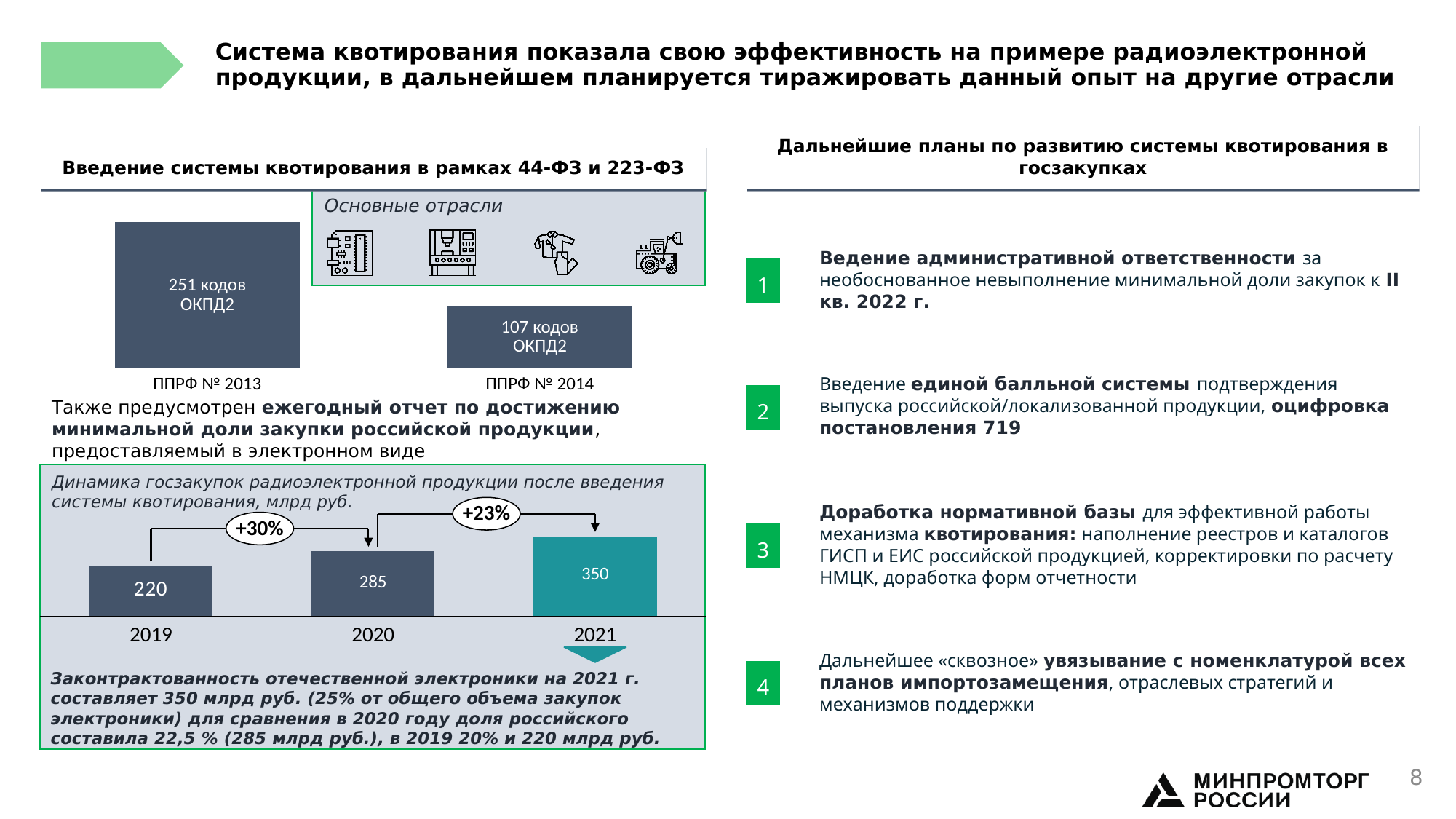
In the chart 'Динамика госзакупок радиоэлектронной продукции после введения системы квотирования, млрд руб.', which year has the highest value? 2021 In the bar chart under 'Введение системы квотирования в рамках 44-ФЗ и 223-ФЗ', how many ОКПД2 codes are shown for ППРФ № 2013? 251 What kind of chart is 'Динамика госзакупок радиоэлектронной продукции после введения системы квотирования, млрд руб.'? bar chart How many years are shown in the chart 'Динамика госзакупок радиоэлектронной продукции после введения системы квотирования, млрд руб.'? 3 In the chart 'Динамика госзакупок радиоэлектронной продукции после введения системы квотирования, млрд руб.', what is the value for 2021? 350 In the chart 'Динамика госзакупок радиоэлектронной продукции после введения системы квотирования, млрд руб.', what percentage growth is shown between 2020 and 2021? +23% In the chart 'Динамика госзакупок радиоэлектронной продукции после введения системы квотирования, млрд руб.', what is the value for 2020? 285 In the chart 'Динамика госзакупок радиоэлектронной продукции после введения системы квотирования, млрд руб.', do the values rise or fall from 2019 to 2021? rise In the bar chart under 'Введение системы квотирования в рамках 44-ФЗ и 223-ФЗ', which has more ОКПД2 codes, ППРФ № 2013 or ППРФ № 2014? ППРФ № 2013 In the chart 'Динамика госзакупок радиоэлектронной продукции после введения системы квотирования, млрд руб.', what is the value for 2019? 220 In the chart 'Динамика госзакупок радиоэлектронной продукции после введения системы квотирования, млрд руб.', what is the difference between the 2021 and 2019 values? 130 In the chart 'Динамика госзакупок радиоэлектронной продукции после введения системы квотирования, млрд руб.', which year has the lowest value? 2019